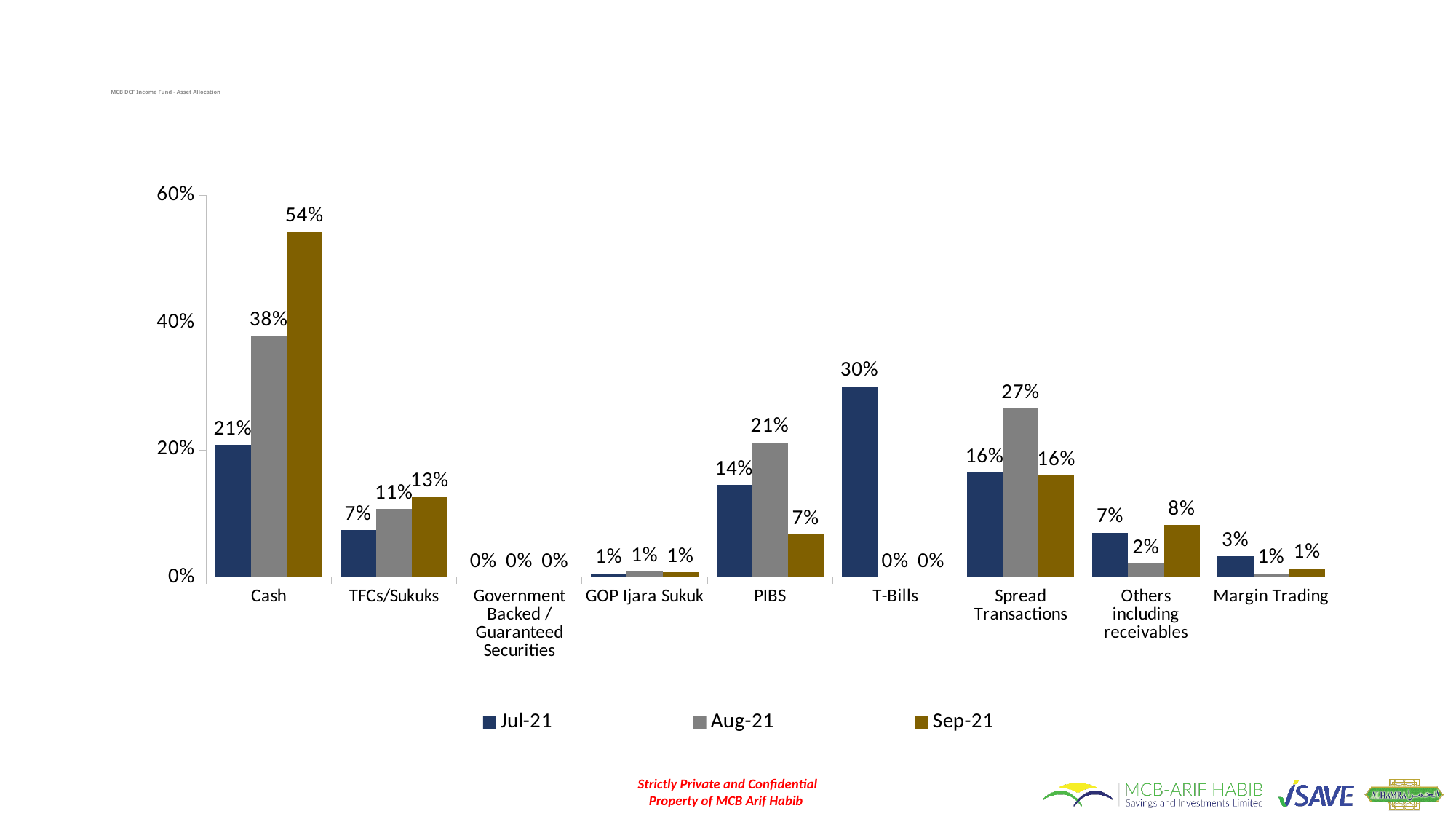
Which category has the highest Sep-21 value? Cash What is the Aug-21 value for Spread Transactions? 27% What is the Jul-21 value for T-Bills? 30% What is the difference between the Sep-21 and Jul-21 values for Cash? 33% How many series does the legend list? 3 What is the Sep-21 value for PIBS? 7% Which is larger for PIBS: the Aug-21 value or the Jul-21 value? Aug-21 What is the Sep-21 value for Cash? 54% What kind of chart is shown on the slide? Bar chart Do the values for Cash rise or fall from Jul-21 to Sep-21? Rise How many categories are shown on the x axis? 9 Which category has the highest Jul-21 value? T-Bills